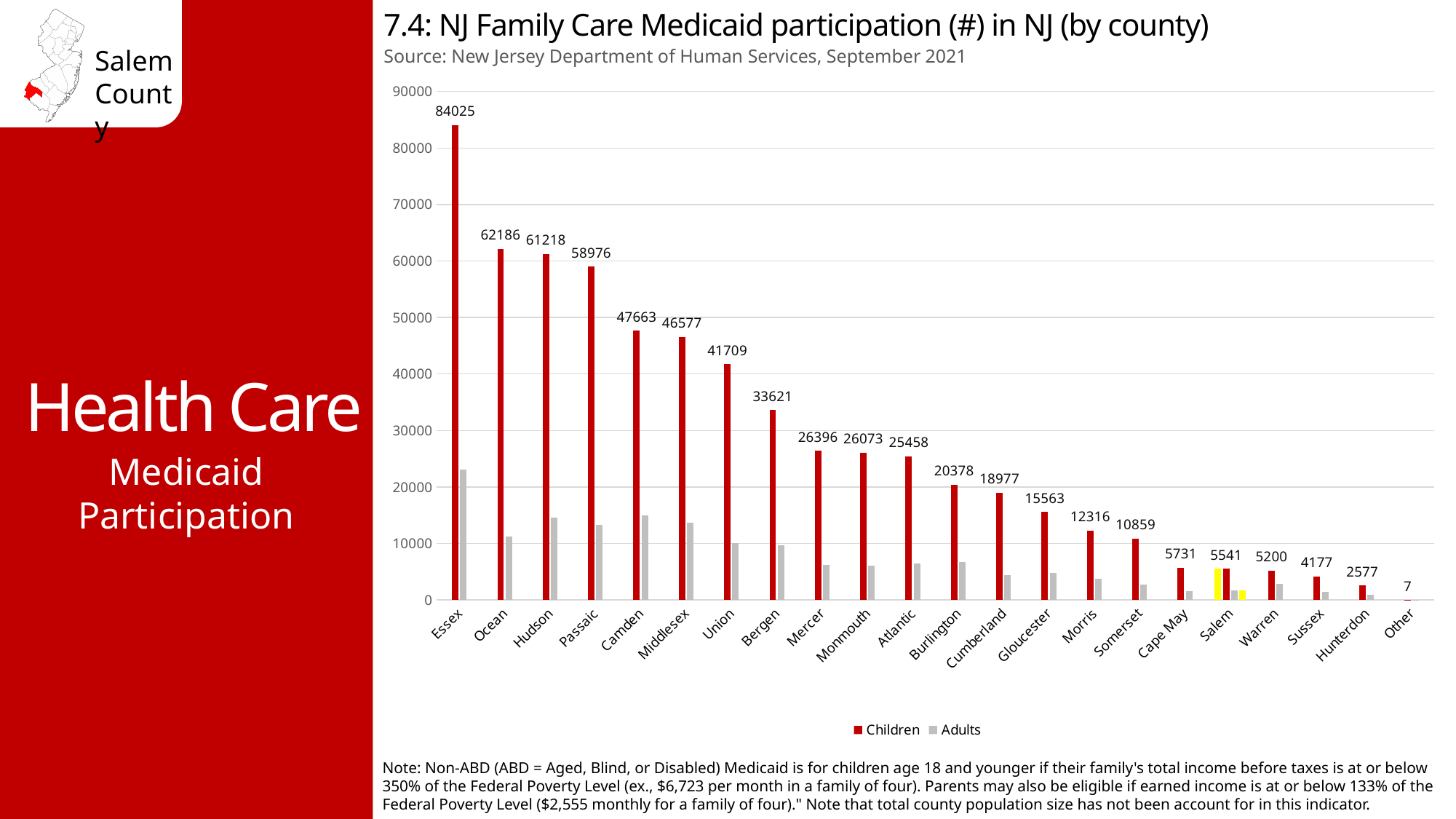
What is the Children value for Salem? 5541 What is the Children value for Essex? 84025 Which county has the highest Children value? Essex Which has a larger Children value, Camden or Union? Camden How many categories are shown on the x axis? 22 Is the Adults value for Essex greater or less than 20000? greater Which category has the lowest Children value? Other How many series does the legend list? 2 Which county's bars are highlighted in yellow? Salem What is the Children value for Cumberland? 18977 What is the difference between the Children values for Ocean and Hudson? 968 What kind of chart is shown? bar chart